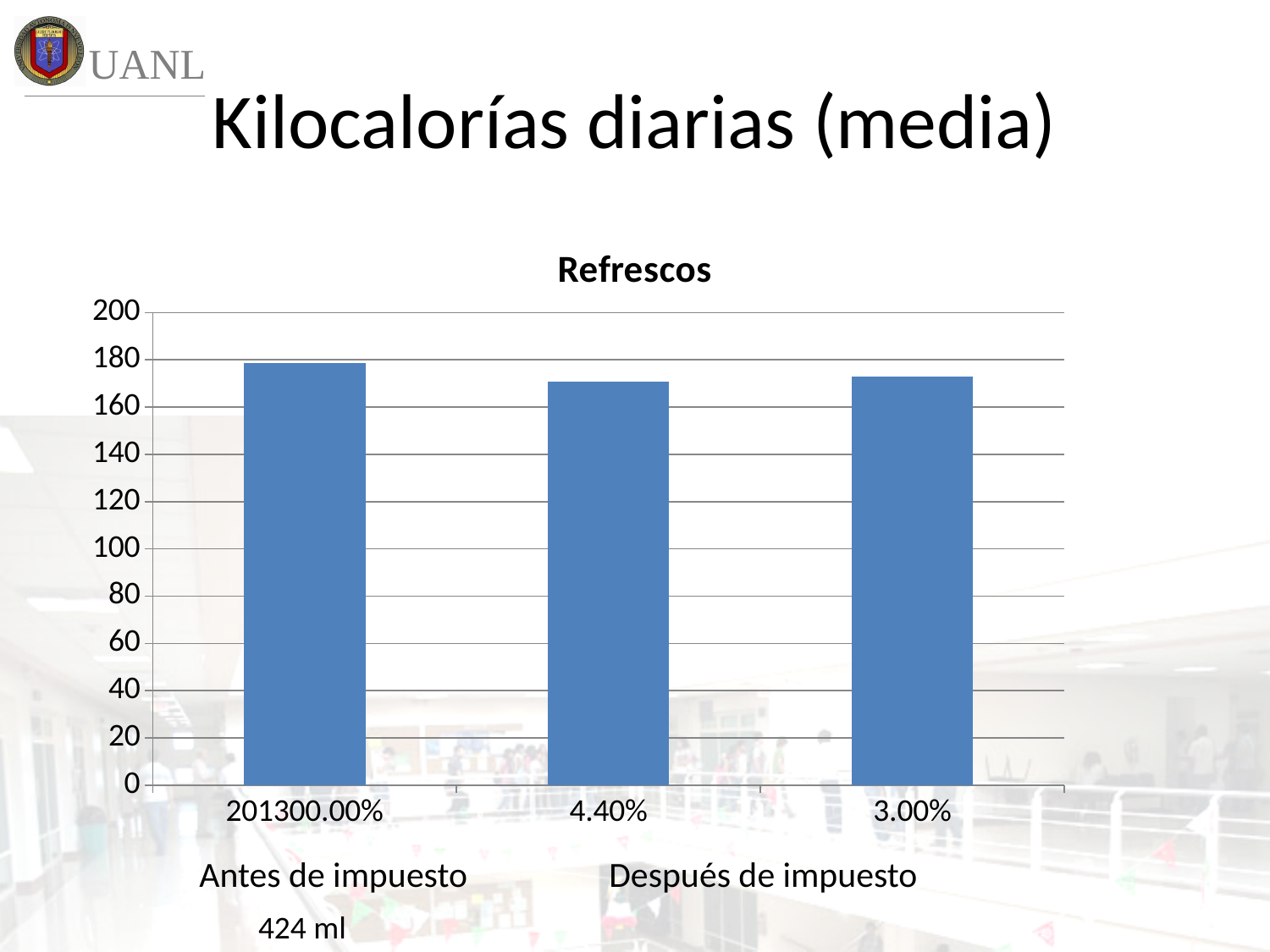
Which category has the highest bar in the chart? 201300.00% What kind of chart is shown on the slide? bar chart Is the value for 201300.00% greater or less than 160? greater What is the title of the chart? Refrescos Is the value for 4.40% greater or less than 180? less Is the value for 3.00% greater or less than 160? greater Which is larger, the value for 201300.00% or the value for 4.40%? 201300.00% How many bars are plotted in the chart? 3 What is the highest value shown on the vertical axis of the chart? 200